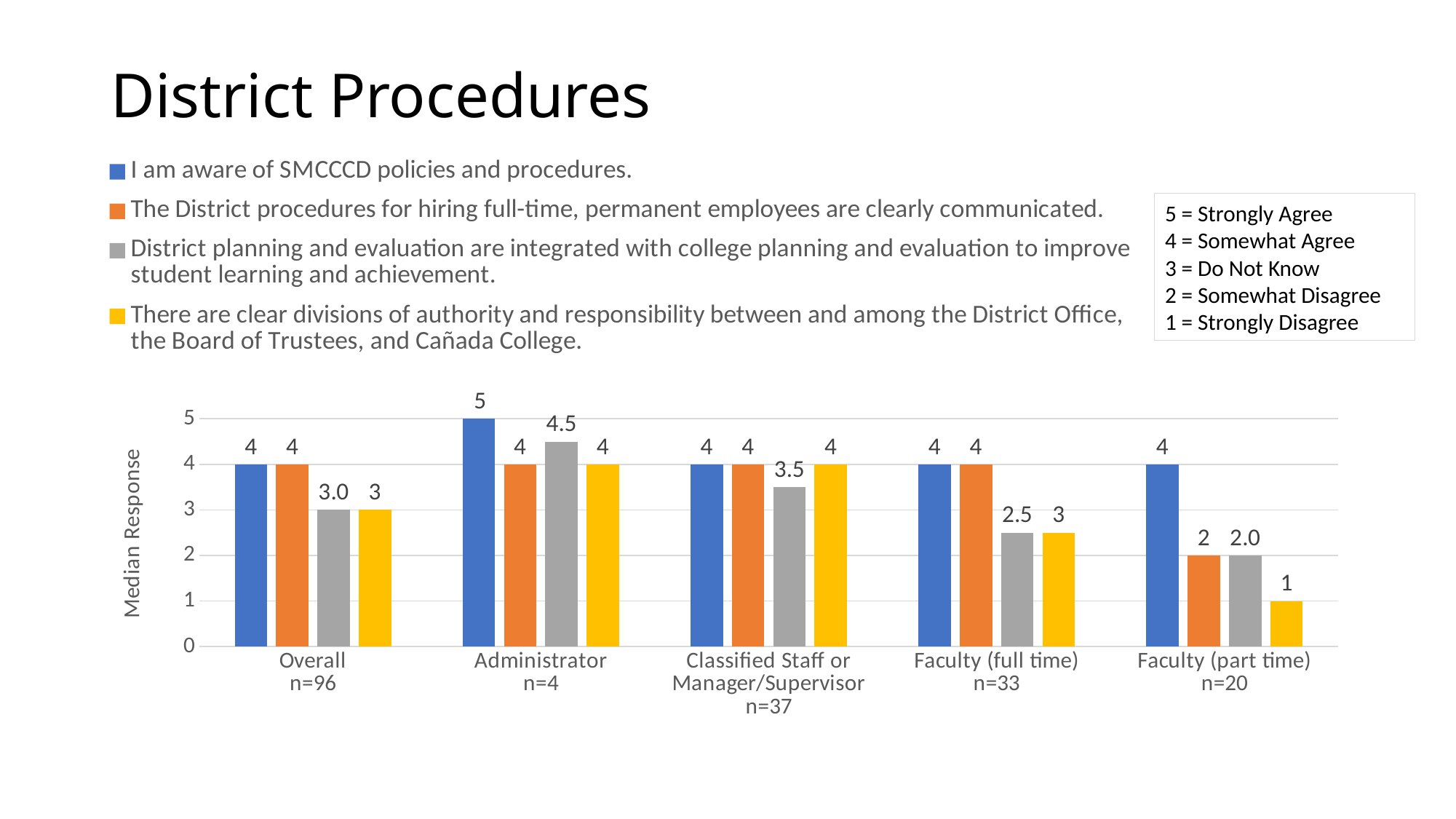
What is the median response for Administrators on 'I am aware of SMCCCD policies and procedures'? 5 What is the median response for Faculty (part time) on 'There are clear divisions of authority and responsibility between and among the District Office, the Board of Trustees, and Cañada College'? 1 Which group has the highest median response on 'I am aware of SMCCCD policies and procedures'? Administrator What is the median response for Classified Staff or Manager/Supervisor on 'District planning and evaluation are integrated with college planning and evaluation to improve student learning and achievement'? 3.5 What kind of chart is shown on the slide? Bar chart What is the median response for Faculty (full time) on 'District planning and evaluation are integrated with college planning and evaluation to improve student learning and achievement'? 2.5 How many respondent groups are shown on the x axis of the chart? 5 How many series does the legend list? 4 What is the difference between the Administrator and Faculty (part time) median responses on 'District planning and evaluation are integrated with college planning and evaluation to improve student learning and achievement'? 2.5 What is the label of the vertical axis of the chart? Median Response Which group has the lowest median response on 'The District procedures for hiring full-time, permanent employees are clearly communicated'? Faculty (part time) Which is larger: the Overall median response on 'I am aware of SMCCCD policies and procedures' or the Overall median response on 'There are clear divisions of authority and responsibility between and among the District Office, the Board of Trustees, and Cañada College'? I am aware of SMCCCD policies and procedures